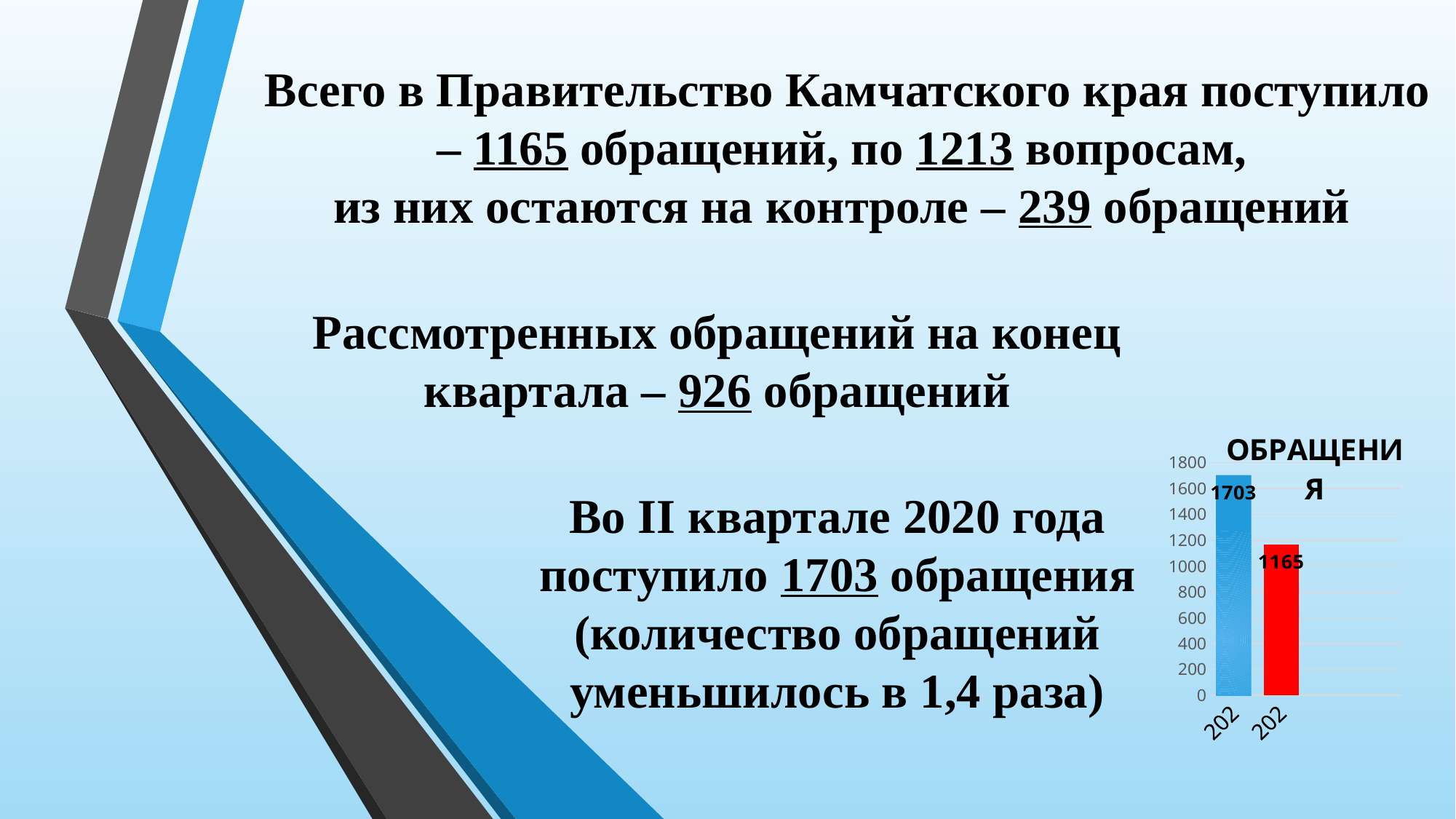
Do the values rise or fall from the left bar to the right bar? fall What is the difference between the left bar (1703) and the right bar (1165)? 538 What is the value of the left (blue) bar in the chart? 1703 How many bars does the chart show? 2 What is the value of the right (red) bar in the chart? 1165 Is the value of the red bar greater or less than 1000? greater Which bar in the chart is the lowest? the right (red) bar What is the title of the chart? ОБРАЩЕНИЯ Which is larger, the blue bar or the red bar? the blue bar What kind of chart is shown on the slide? bar chart Which bar in the chart is the highest? the left (blue) bar What is the highest value shown on the chart's vertical axis? 1800